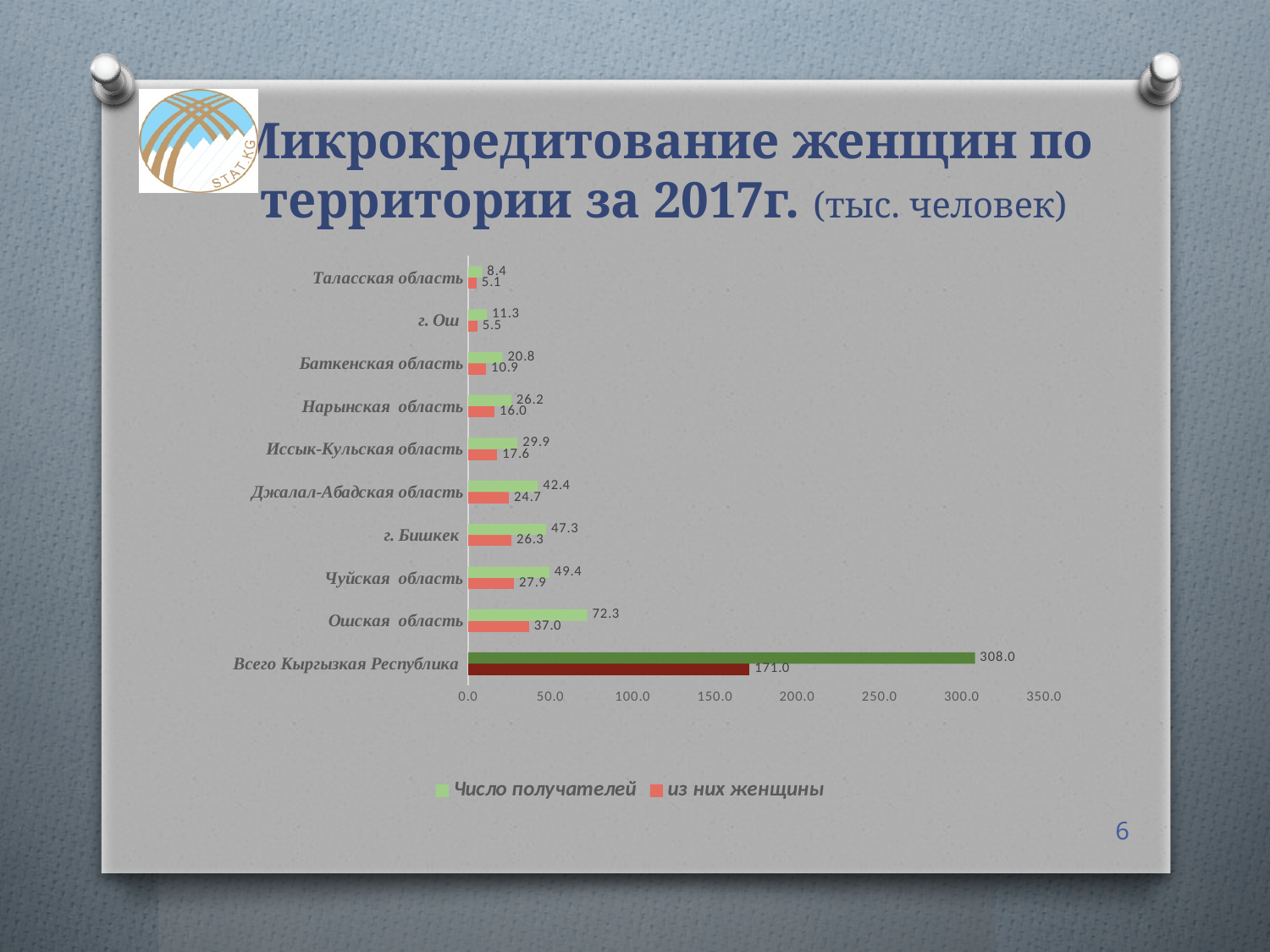
What is the value of "Число получателей" for Ошская область? 72.3 What is the value of "Число получателей" for Всего Кыргызкая Республика? 308.0 What is the value of "из них женщины" for г. Бишкек? 26.3 Which category has the lowest value of "из них женщины"? Таласская область What type of chart is shown on the slide? bar chart Is the value of "Число получателей" for Джалал-Абадская область greater or less than 50.0? less How many series does the legend list? 2 Which is larger: "из них женщины" for Нарынская область or for Иссык-Кульская область? Иссык-Кульская область What is the value of "из них женщины" for Таласская область? 5.1 Excluding the total for Всего Кыргызкая Республика, which category has the highest value of "Число получателей"? Ошская область What is the difference between "Число получателей" and "из них женщины" for Чуйская область? 21.5 How many categories are shown on the vertical axis of the chart? 10